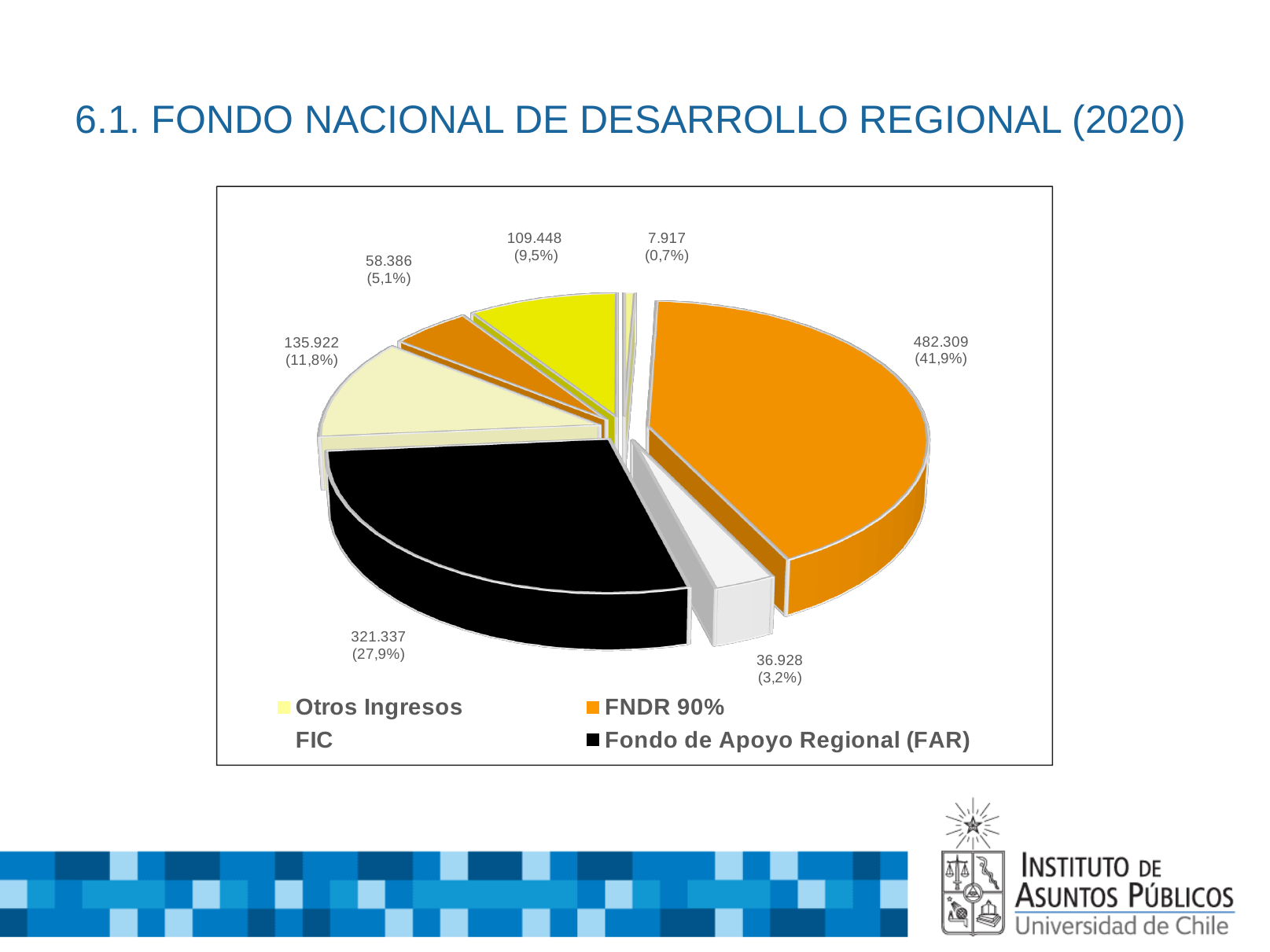
What percentage share does the Fondo de Apoyo Regional (FAR) slice have? 27,9% What type of chart is shown on the slide? Pie chart What is the value of the smallest slice in the pie? 7.917 What is the value shown for the Fondo de Apoyo Regional (FAR) slice? 321.337 How many slices does the pie chart have? 7 What is the value shown for the Otros Ingresos slice? 7.917 What percentage share does the FNDR 90% slice have? 41,9% What is the value shown for the FNDR 90% slice? 482.309 Which is larger, the Otros Ingresos slice or the Fondo de Apoyo Regional (FAR) slice? Fondo de Apoyo Regional (FAR) What is the difference between the FNDR 90% value and the Fondo de Apoyo Regional (FAR) value? 160.972 Which legend category has the largest slice of the pie? FNDR 90% How many entries does the legend list? 4